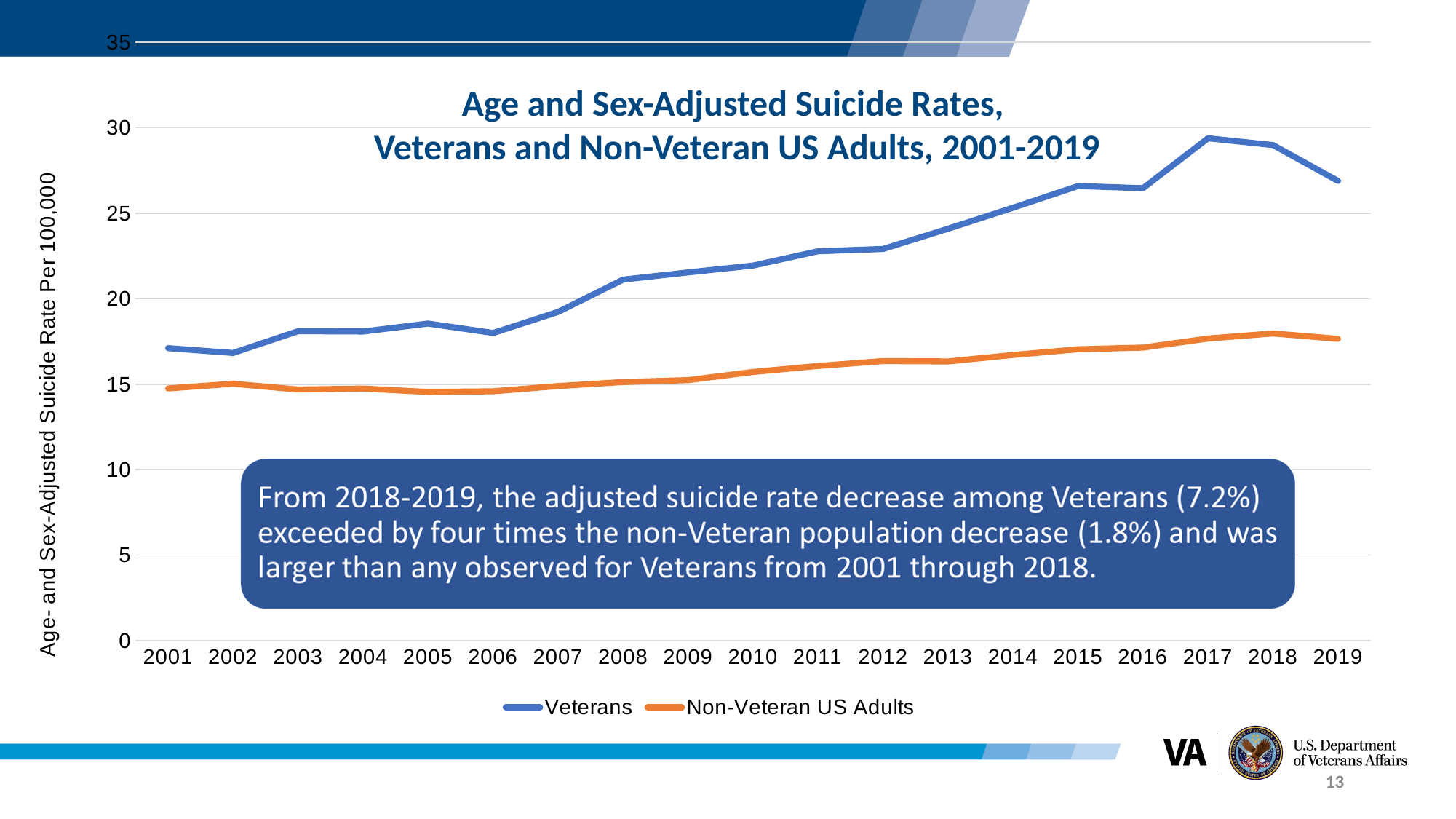
How many series does the legend list? 2 Which colour represents the Non-Veteran US Adults series? Orange In which year does the Veterans line reach its highest value? 2017 Does the Veterans line generally rise or fall from 2001 to 2017? Rise In 2019, which series has the higher value, Veterans or Non-Veteran US Adults? Veterans Is the value for Non-Veteran US Adults in 2005 greater or less than 20? less Is the value for Non-Veteran US Adults in 2019 greater or less than 15? greater Is the value for Veterans in 2001 greater or less than 20? less What is the title of the chart? Age and Sex-Adjusted Suicide Rates, Veterans and Non-Veteran US Adults, 2001-2019 How many years are plotted along the x axis? 19 What kind of chart is shown on the slide? Line chart